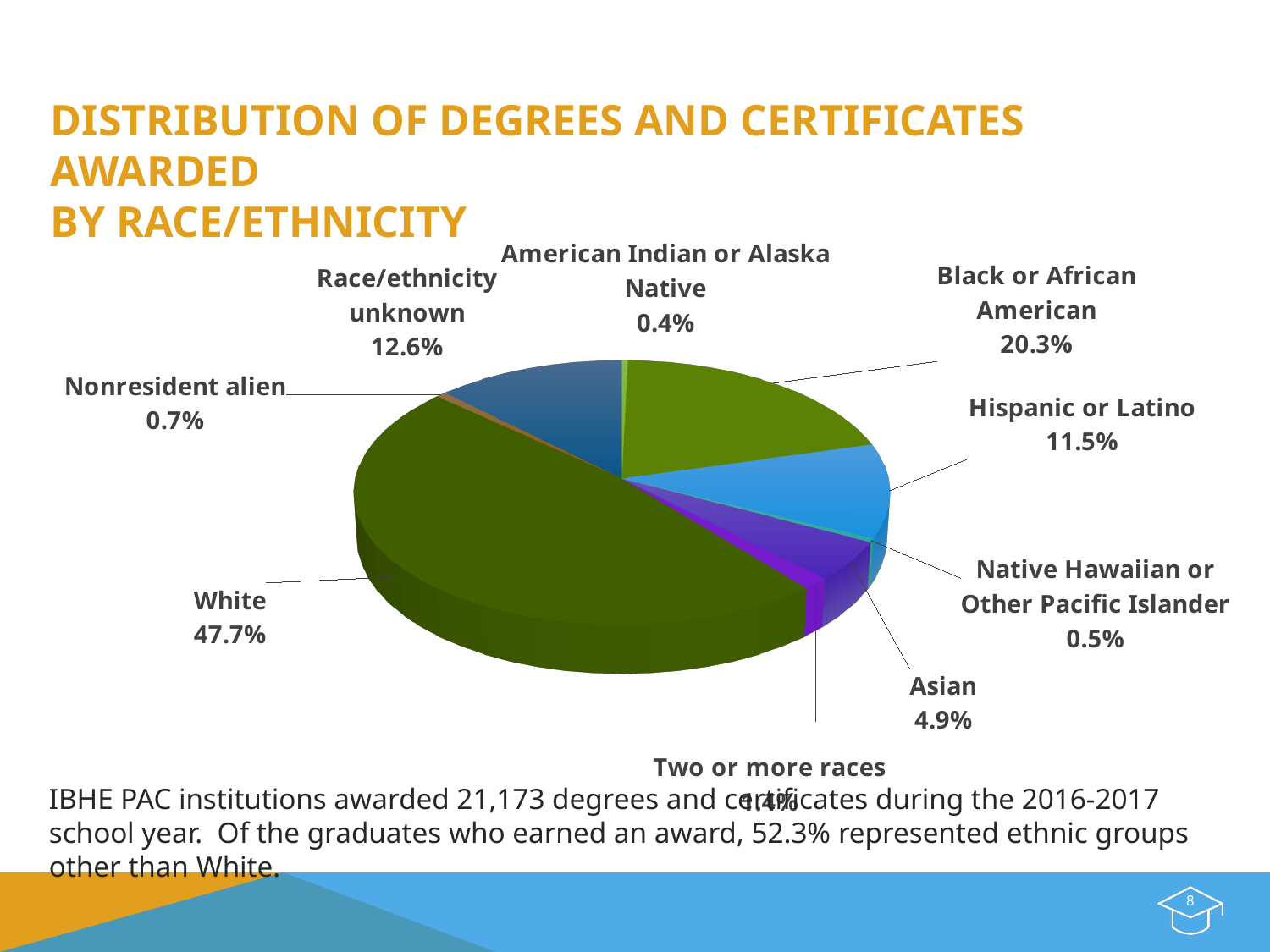
Which race/ethnicity category has the largest share of the pie? White What is the difference in percentage points between the White and Black or African American shares? 27.4 Which is larger, the share for Asian or the share for Hispanic or Latino? Hispanic or Latino What percentage is shown for Race/ethnicity unknown? 12.6% What percentage is shown for Nonresident alien? 0.7% What type of chart is shown on the slide? Pie chart Which is larger, the share for Black or African American or the share for Hispanic or Latino? Black or African American What percentage of awards went to Black or African American graduates? 20.3% How many race/ethnicity categories are shown in the pie chart? 9 What is the value for Asian? 4.9% What share of degrees and certificates was awarded to White graduates? 47.7% What is the value shown for Hispanic or Latino? 11.5%